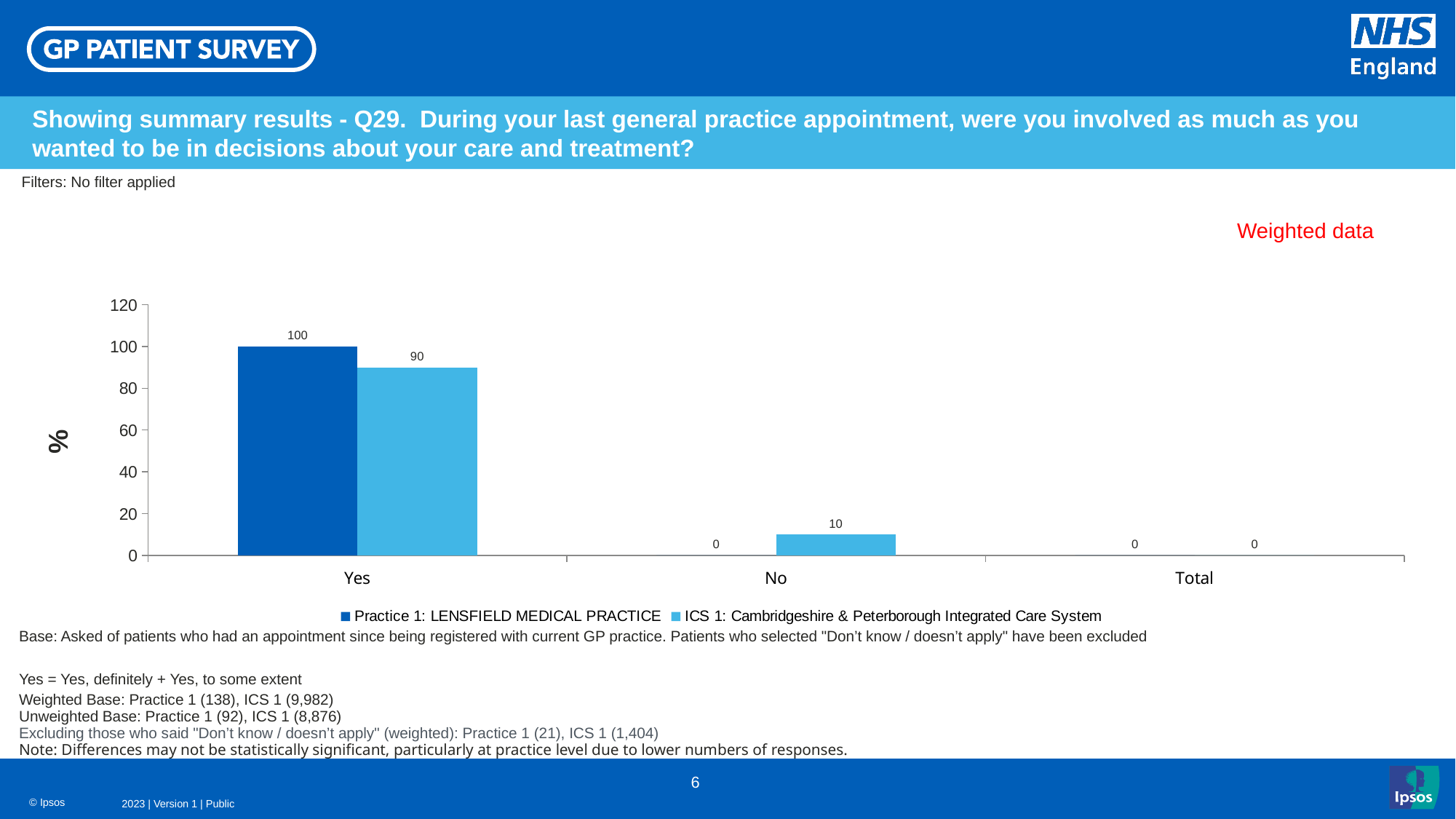
What is the value for Practice 1: LENSFIELD MEDICAL PRACTICE in the Yes category? 100 How many categories are shown on the x axis? 3 Which category has the highest value for Practice 1: LENSFIELD MEDICAL PRACTICE? Yes What is the value for ICS 1: Cambridgeshire & Peterborough Integrated Care System in the No category? 10 What kind of chart is shown on the slide? Bar chart In the Yes category, which series has the larger value: Practice 1 or ICS 1? Practice 1: LENSFIELD MEDICAL PRACTICE What is the value for ICS 1: Cambridgeshire & Peterborough Integrated Care System in the Yes category? 90 How many series does the legend list? 2 Is the value for ICS 1 in the Yes category greater or less than 80? greater What is the difference between the Practice 1 and ICS 1 values in the Yes category? 10 What is the value for Practice 1: LENSFIELD MEDICAL PRACTICE in the No category? 0 What is the label on the y axis of the chart? %